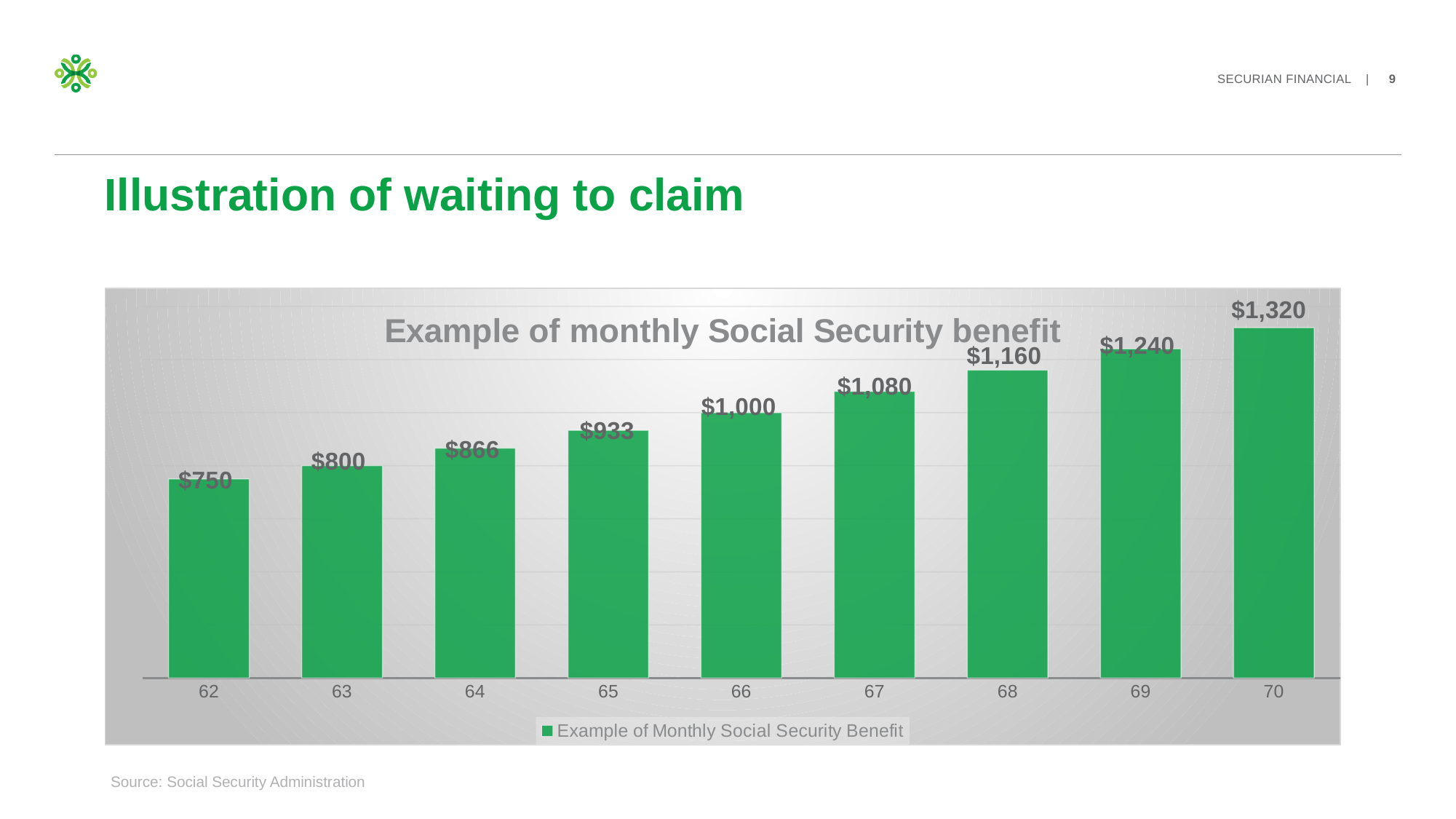
What is the difference between the monthly benefit at age 70 and at age 62? $570 What is the example monthly Social Security benefit at age 65? $933 What is the difference between the monthly benefit at age 68 and at age 67? $80 At which age is the example monthly benefit lowest? 62 At which age is the example monthly benefit highest? 70 Which is larger, the monthly benefit at age 64 or at age 69? 69 Do the monthly benefit values rise or fall as age increases from 62 to 70? Rise What is the example monthly Social Security benefit at age 66? $1,000 What is the example monthly Social Security benefit at age 70? $1,320 How many ages are shown on the x axis of the chart? 9 What is the example monthly Social Security benefit at age 62? $750 What kind of chart is shown on the slide? Bar chart